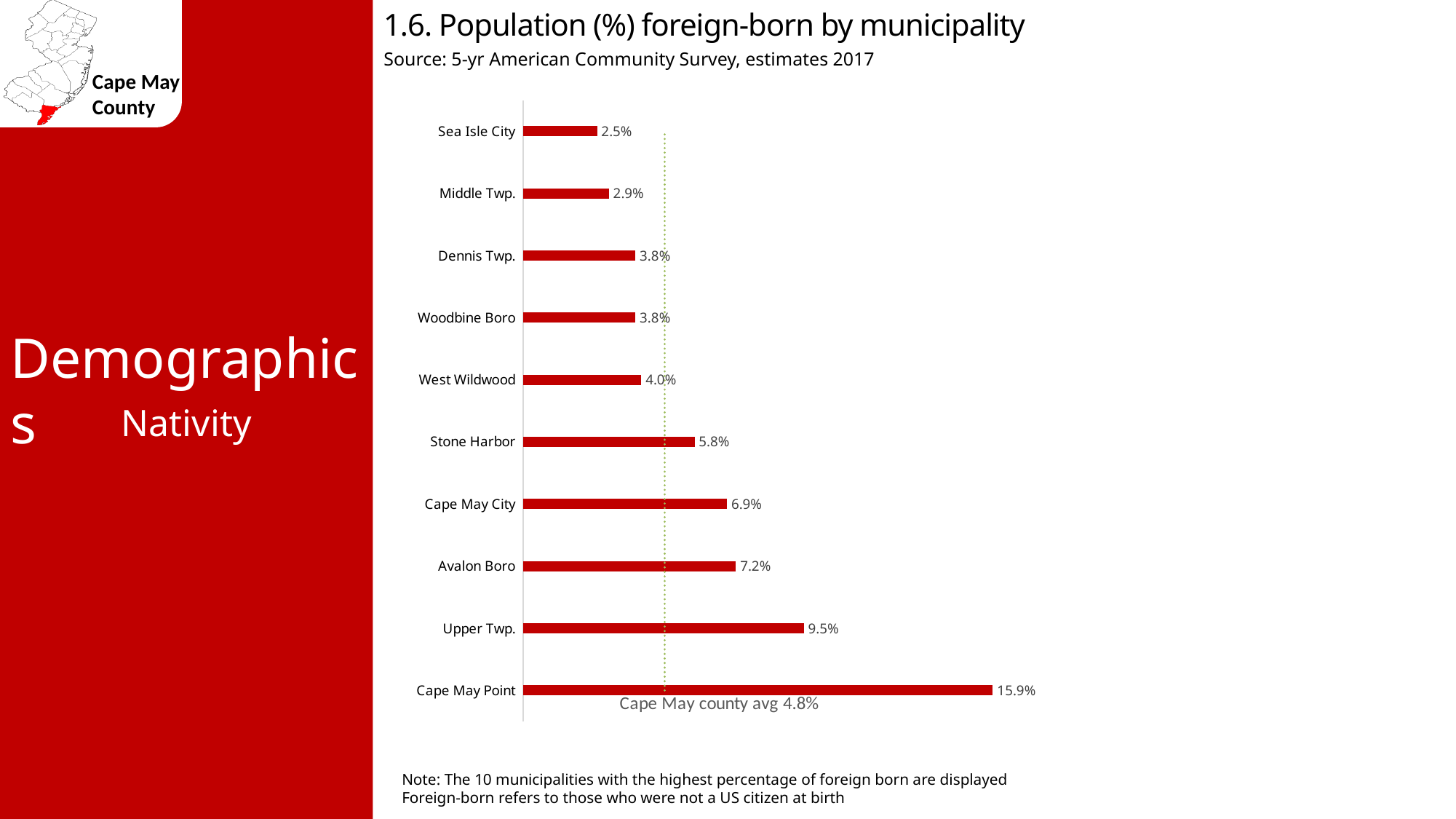
What is the foreign-born population percentage for Stone Harbor? 5.8% Which has a higher foreign-born percentage, Middle Twp. or West Wildwood? West Wildwood What is the Cape May county average foreign-born percentage shown by the dotted line? 4.8% Which municipality has the lowest foreign-born population percentage? Sea Isle City What is the difference in foreign-born percentage between Cape May Point and Upper Twp.? 6.4% What kind of chart is used to show the foreign-born population by municipality? Bar chart What is the source of the data in the chart? 5-yr American Community Survey, estimates 2017 What is the foreign-born population percentage for Upper Twp.? 9.5% How many municipalities are shown in the chart? 10 Which municipality has the highest foreign-born population percentage? Cape May Point What is the difference in foreign-born percentage between Avalon Boro and Cape May City? 0.3% What is the foreign-born population percentage for Cape May Point? 15.9%